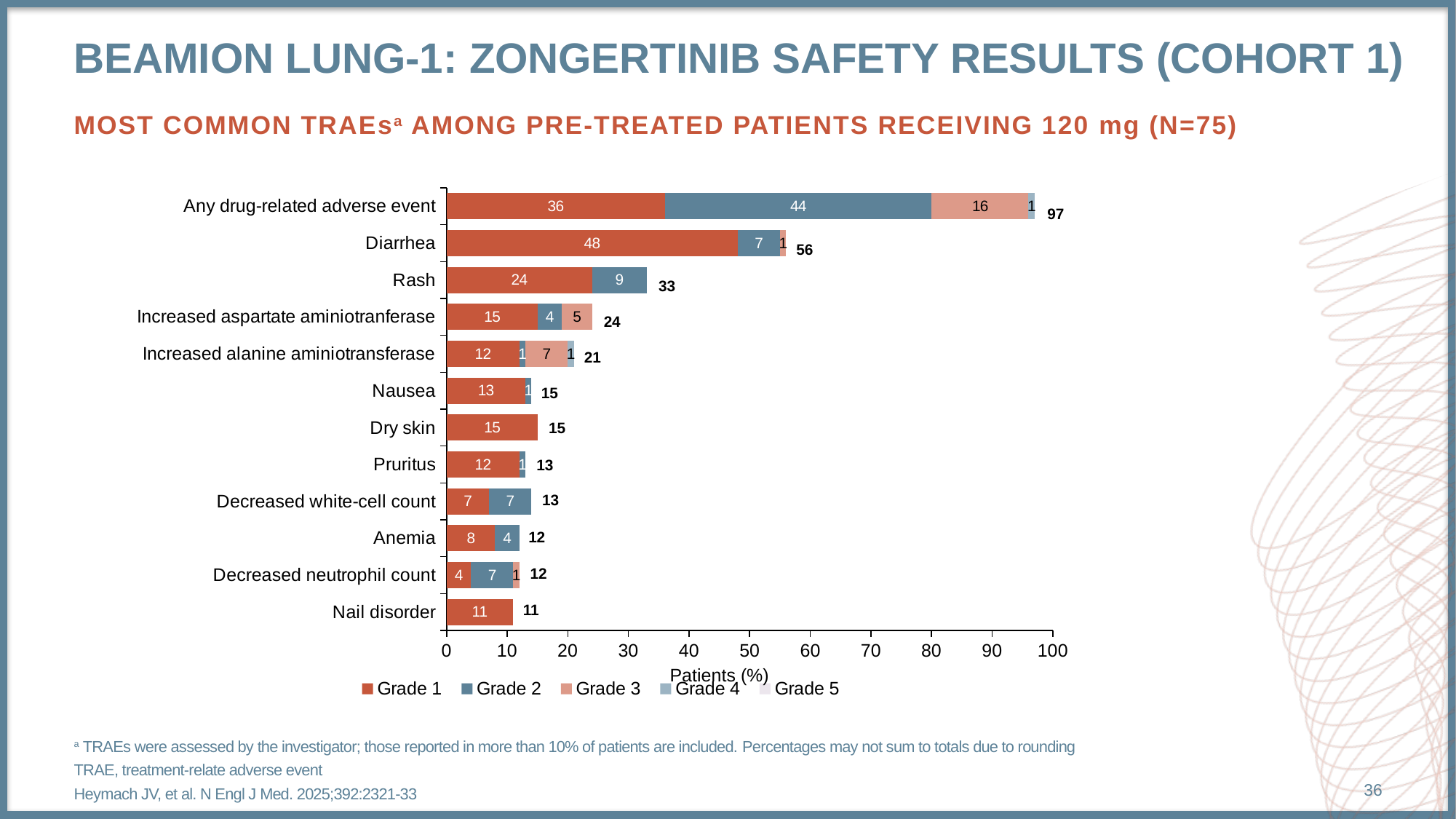
Which category has the lowest total value? Nail disorder What is the Grade 3 value for Increased alanine aminiotransferase? 7 What type of chart is shown on the slide? Stacked bar chart Which has a larger Grade 1 value, Rash or Increased aspartate aminiotranferase? Rash How many series does the legend list? 5 What is the label of the x axis? Patients (%) What is the total value shown for Rash? 33 What is the Grade 2 value for Any drug-related adverse event? 44 Excluding Any drug-related adverse event, which category has the highest total value? Diarrhea How many adverse event categories are plotted on the chart? 12 What is the difference between the total for Diarrhea and the total for Rash? 23 What is the Grade 1 value for Diarrhea? 48